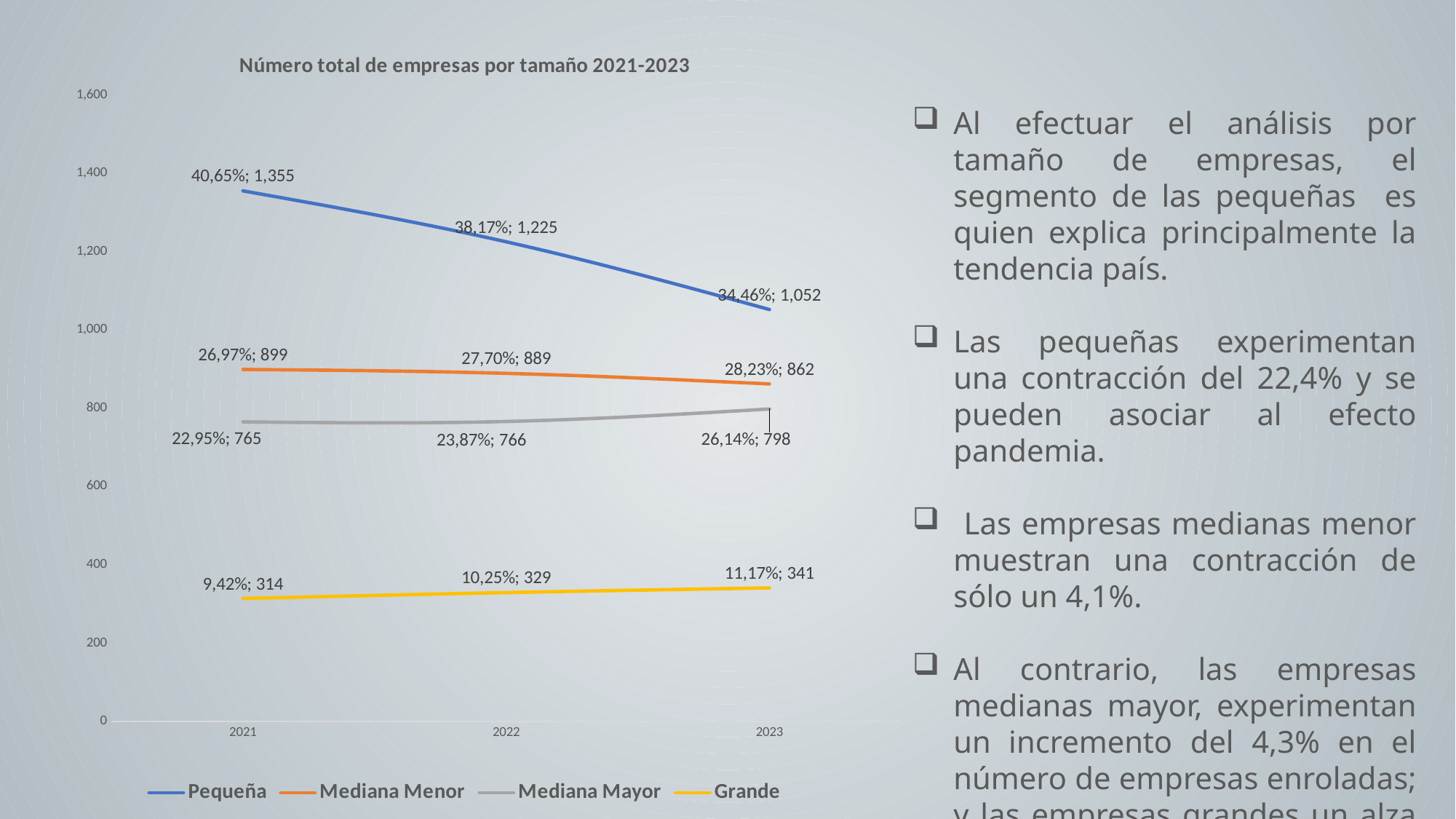
What kind of chart is shown on the slide? line chart What is the title of the chart? Número total de empresas por tamaño 2021-2023 What is the difference between the Pequeña values in 2021 and 2023? 303 What percentage share is shown for Grande in 2022? 10,25% What is the number of Pequeña companies in 2021? 1,355 What is the number of Mediana Menor companies in 2023? 862 Does the Pequeña series rise or fall from 2021 to 2023? fall How many years are shown on the x axis? 3 Which series has the lowest value in 2021? Grande How many series does the legend list? 4 Which is larger in 2023: Mediana Mayor or Grande? Mediana Mayor Which series has the highest value in 2023? Pequeña